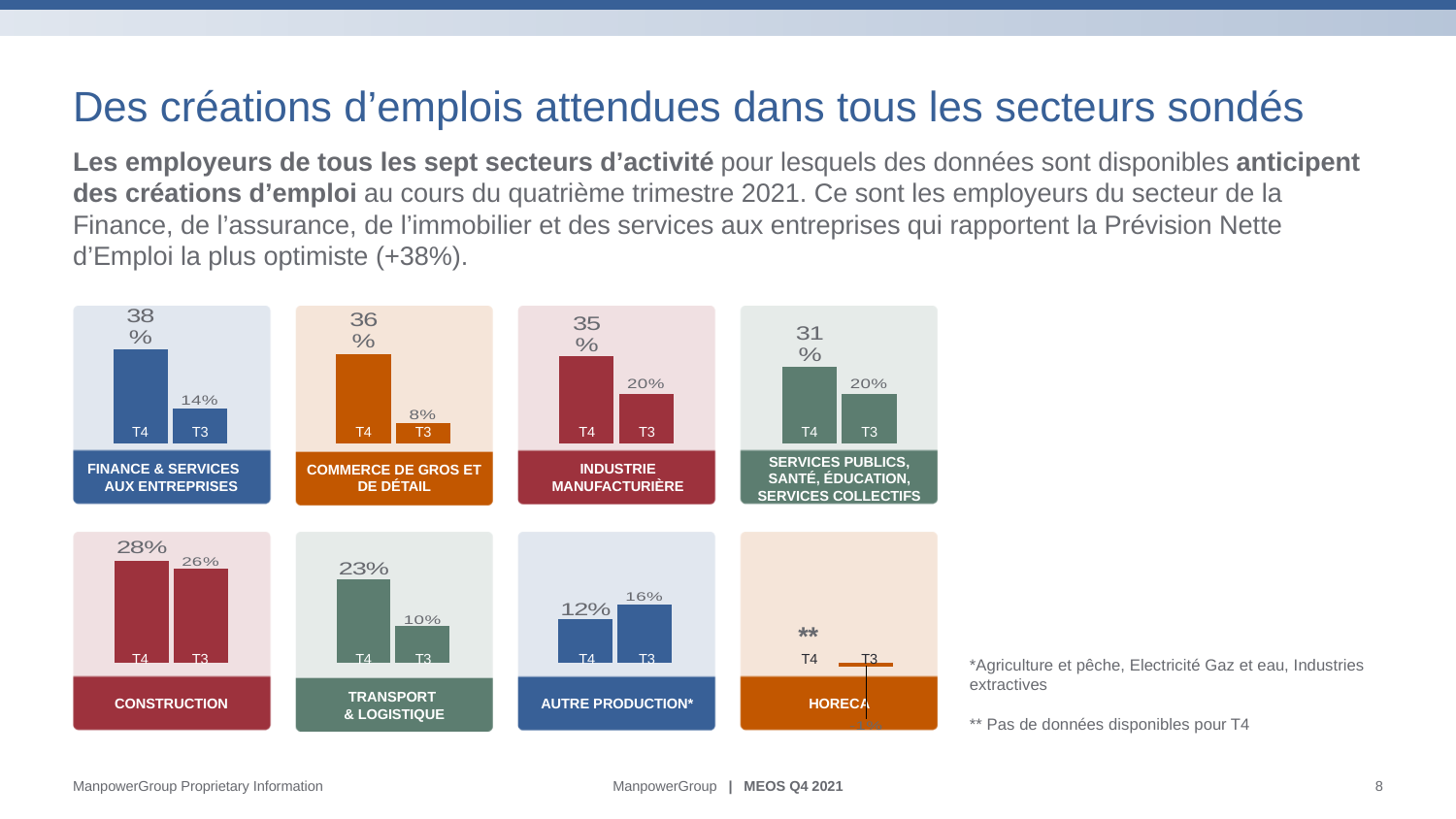
What kind of chart is used for the Industrie manufacturière sector? Bar chart In the Finance & Services aux entreprises chart, what is the value for T4? 38% In the Transport & Logistique chart, which is larger, T4 or T3? T4 In the Commerce de gros et de détail chart, how many bars are plotted? 2 In the Services publics, santé, éducation, services collectifs chart, what is the value for T4? 31% In the Transport & Logistique chart, what is the value for T4? 23% Which sector chart on the slide shows no data available for T4? HORECA In the Construction chart, what is the difference between the T4 and T3 values? 2% In the Commerce de gros et de détail chart, what is the value for T3? 8% In the Industrie manufacturière chart, what is the value for T3? 20% In the Autre production* chart, which is larger, T4 or T3? T3 In the Finance & Services aux entreprises chart, what is the difference between the T4 and T3 values? 24%